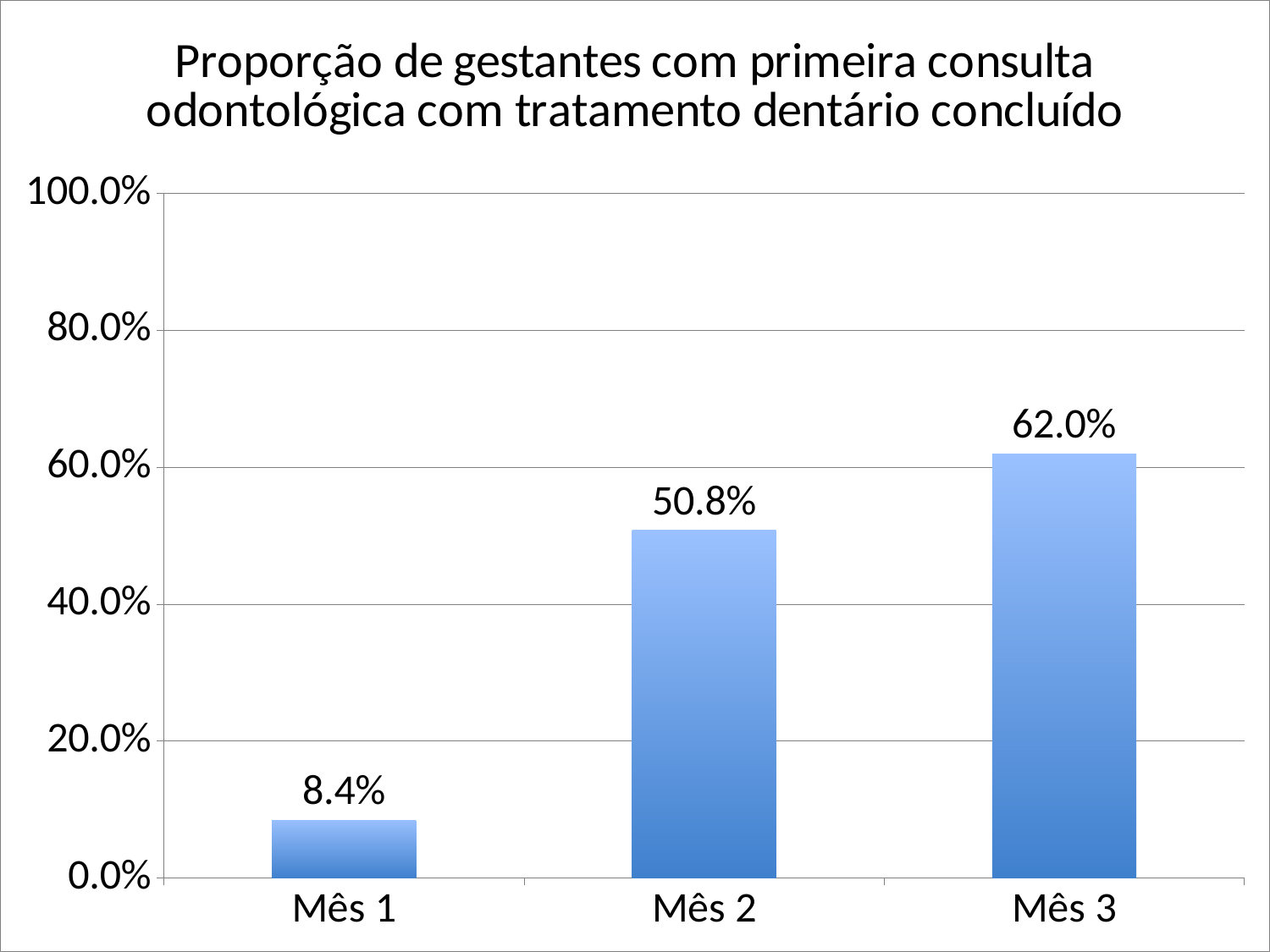
How many categories are shown on the x axis? 3 Which is larger, the value for Mês 1 or the value for Mês 2? Mês 2 Do the values rise or fall from Mês 1 to Mês 3? rise What is the difference between the values for Mês 3 and Mês 2? 11.2% What is the value for Mês 2? 50.8% What is the difference between the values for Mês 2 and Mês 1? 42.4% Is the value for Mês 3 greater or less than 60.0%? greater What is the value for Mês 3? 62.0% Which month has the highest value? Mês 3 Which month has the lowest value? Mês 1 What is the value for Mês 1? 8.4% What kind of chart is this? bar chart